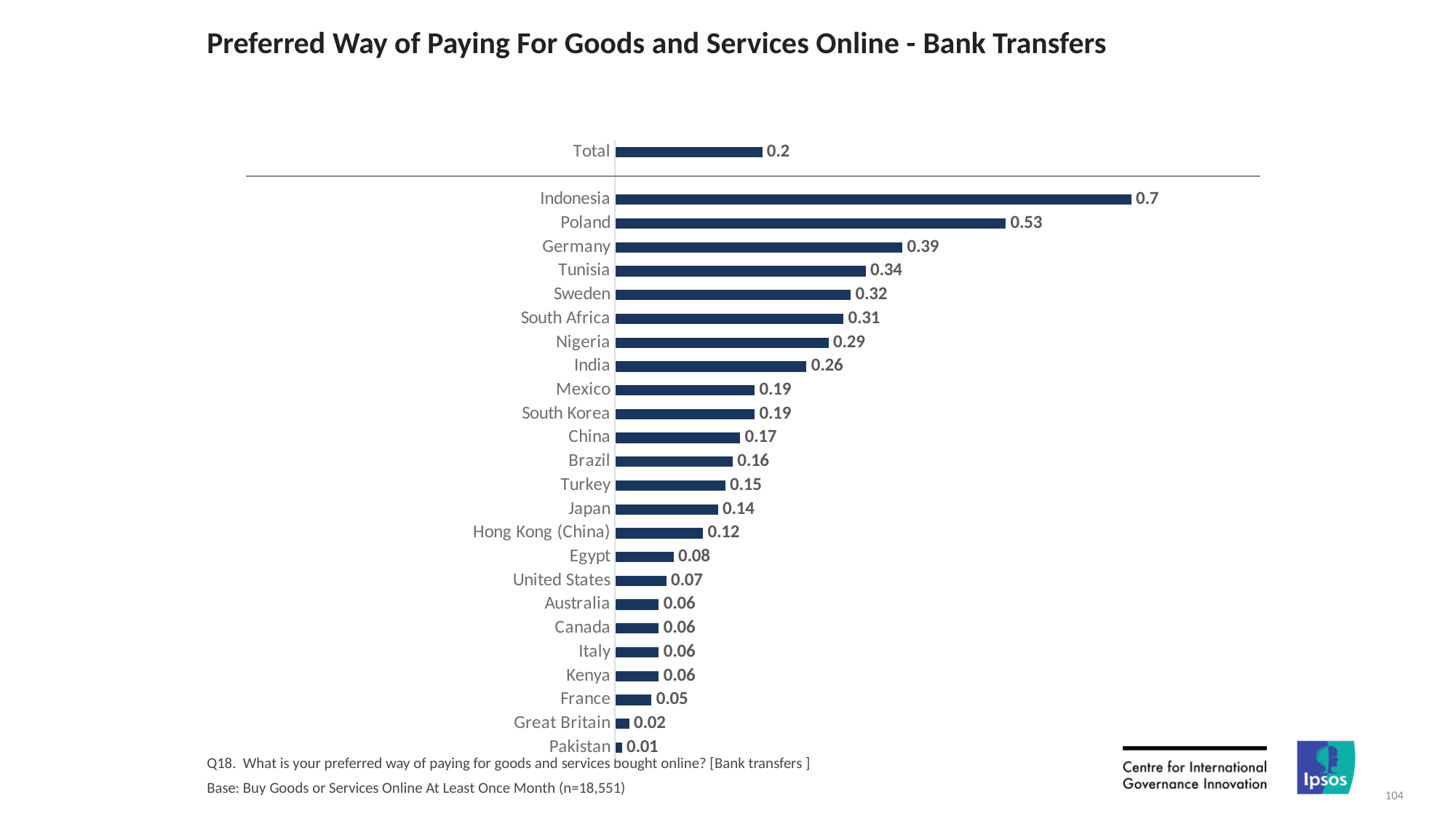
What kind of chart is shown on the slide? Bar chart What is the value for Indonesia? 0.7 How many countries (excluding Total) are shown in the chart? 24 What is the difference between the values for Germany and Egypt? 0.31 Which country has the highest value? Indonesia What is the value for Germany? 0.39 What is the value for Hong Kong (China)? 0.12 What is the title of the chart? Preferred Way of Paying For Goods and Services Online - Bank Transfers What is the difference between the values for Indonesia and Poland? 0.17 Which country has the lowest value? Pakistan What is the value for the Total bar? 0.2 Which has a larger value, Tunisia or Nigeria? Tunisia